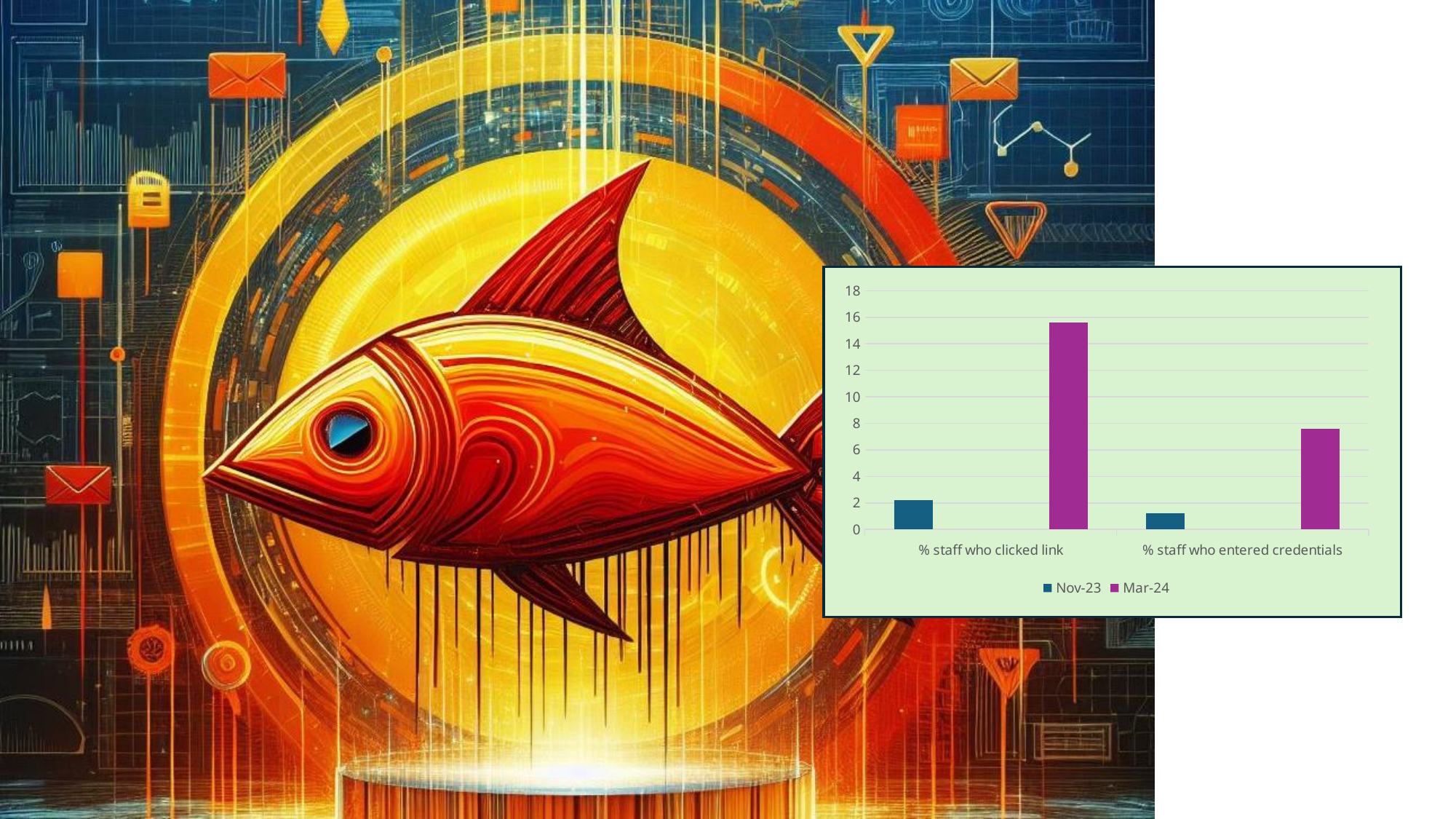
Is the Nov-23 value for '% staff who clicked link' greater or less than 4? less How many categories are shown on the x axis of the chart? 2 Which bar in the chart is the tallest? Mar-24, % staff who clicked link Which series has the higher value for '% staff who clicked link', Nov-23 or Mar-24? Mar-24 Is the Mar-24 value for '% staff who clicked link' greater or less than 14? greater How many series does the chart's legend list? 2 Which bar in the chart is the shortest? Nov-23, % staff who entered credentials What kind of chart is shown on the slide? bar chart Which series has the higher value for '% staff who entered credentials', Nov-23 or Mar-24? Mar-24 Is the Mar-24 value for '% staff who entered credentials' greater or less than 6? greater What colour are the Mar-24 bars in the chart? purple